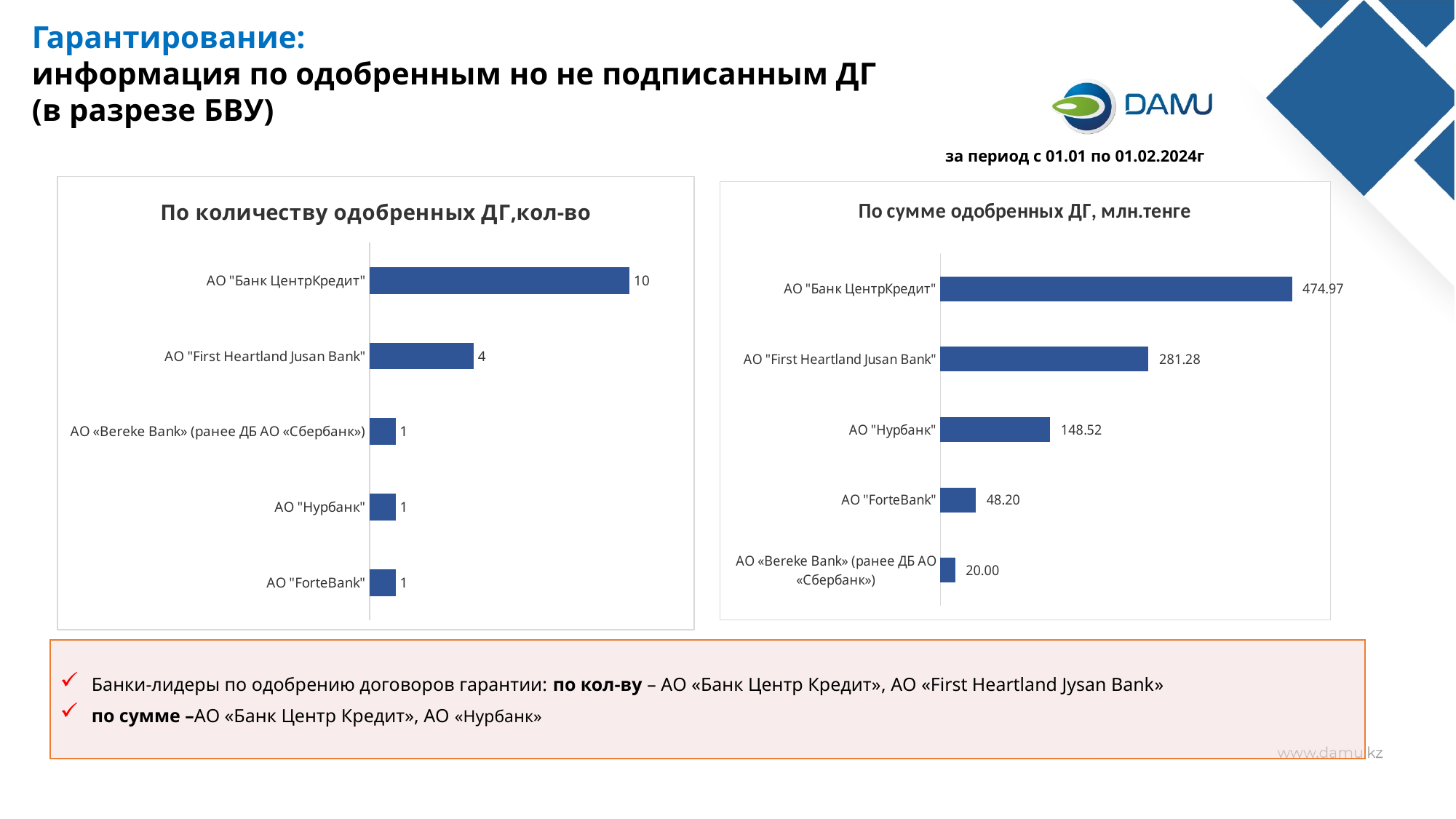
In the chart "По количеству одобренных ДГ,кол-во", what is the value for АО "First Heartland Jusan Bank"? 4 In the chart "По количеству одобренных ДГ,кол-во", what is the value for АО "Банк ЦентрКредит"? 10 In the chart "По сумме одобренных ДГ, млн.тенге", what is the value for АО "Нурбанк"? 148.52 What type of chart is "По сумме одобренных ДГ, млн.тенге"? Bar chart What period is stated on the slide for the data? за период с 01.01 по 01.02.2024г In the chart "По сумме одобренных ДГ, млн.тенге", which bank has the lowest value? АО «Bereke Bank» (ранее ДБ АО «Сбербанк») In the chart "По сумме одобренных ДГ, млн.тенге", which is larger: АО "First Heartland Jusan Bank" or АО "Нурбанк"? АО "First Heartland Jusan Bank" In the chart "По количеству одобренных ДГ,кол-во", how many banks are shown? 5 In the chart "По количеству одобренных ДГ,кол-во", what is the difference between АО "Банк ЦентрКредит" and АО "First Heartland Jusan Bank"? 6 In the chart "По сумме одобренных ДГ, млн.тенге", what is the difference between АО "Банк ЦентрКредит" and АО "First Heartland Jusan Bank"? 193.69 In the chart "По сумме одобренных ДГ, млн.тенге", what is the value for АО "ForteBank"? 48.20 In the chart "По количеству одобренных ДГ,кол-во", which bank has the highest value? АО "Банк ЦентрКредит"